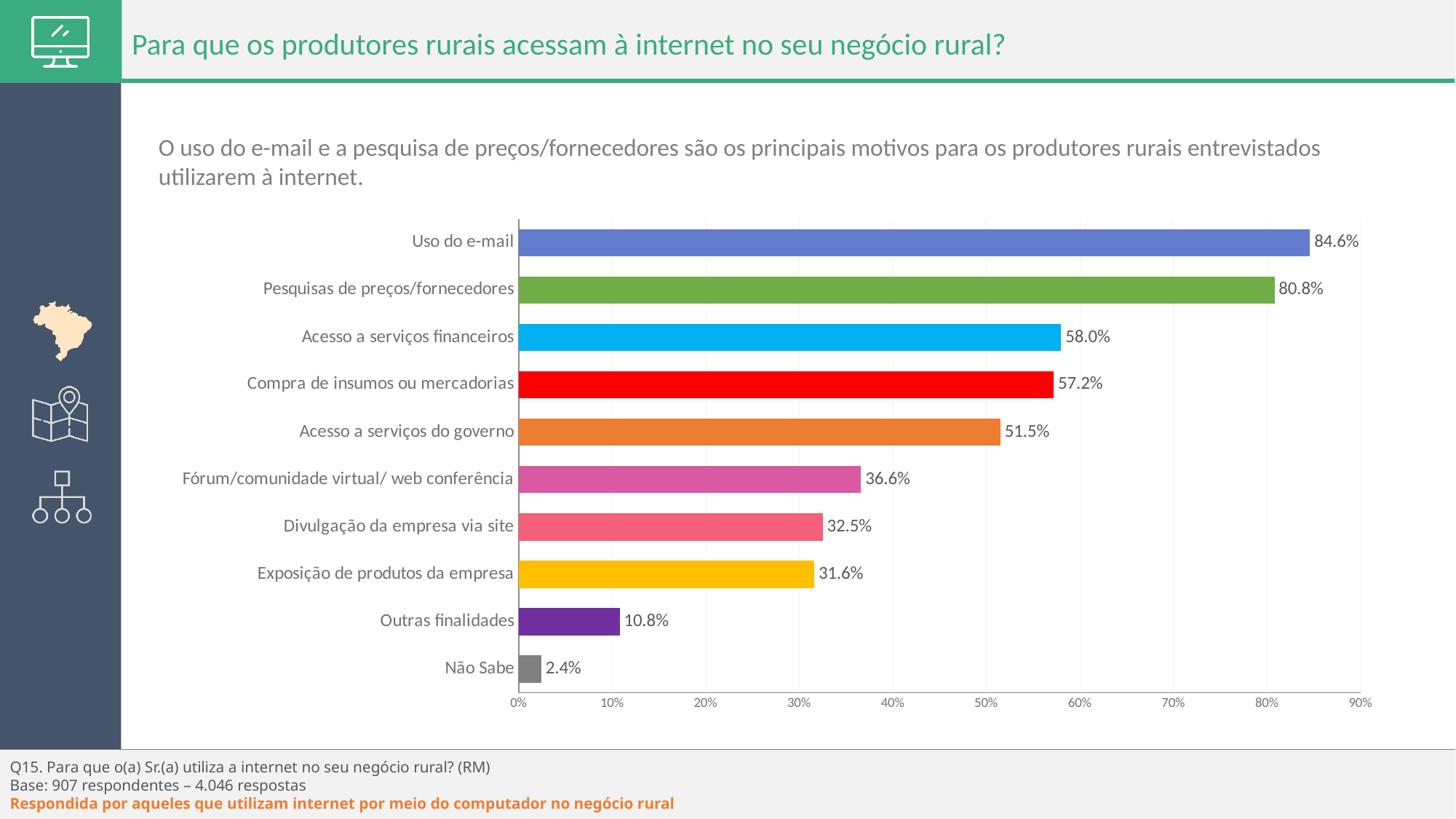
What is the maximum value shown on the horizontal axis? 90% What is the difference between Uso do e-mail and Pesquisas de preços/fornecedores? 3.8% How many categories are shown in the chart? 10 What kind of chart is shown on the slide? bar chart What is the value for Exposição de produtos da empresa? 31.6% What is the value for Uso do e-mail? 84.6% Which category has the lowest value? Não Sabe Is the value for Outras finalidades greater or less than 20%? less Which category has the highest value? Uso do e-mail What is the difference between Fórum/comunidade virtual/ web conferência and Divulgação da empresa via site? 4.1% What is the value for Acesso a serviços do governo? 51.5% Which is larger: Compra de insumos ou mercadorias or Acesso a serviços do governo? Compra de insumos ou mercadorias